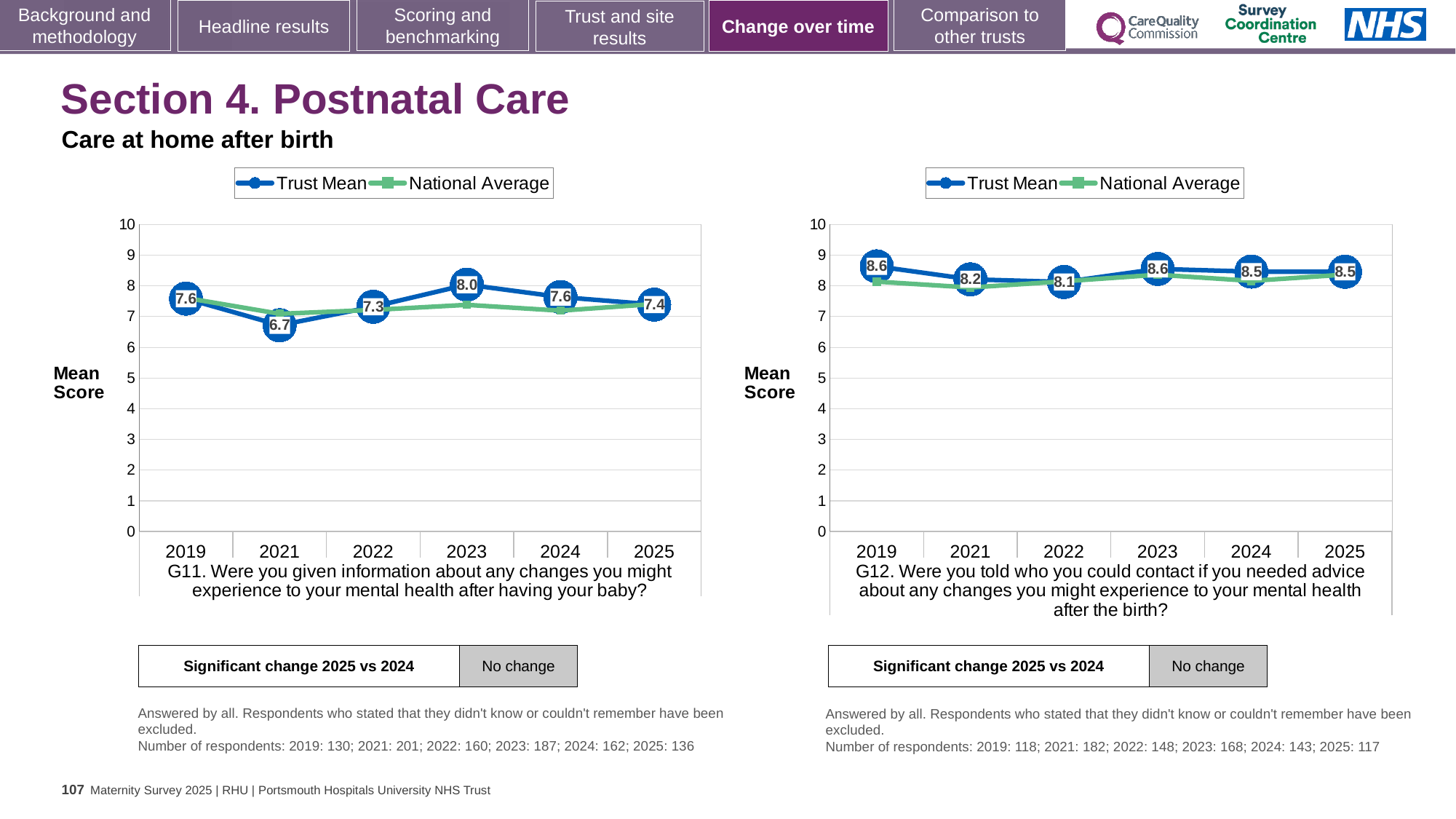
On the G11 chart (left), which year has the lowest Trust Mean score? 2021 How many series does the legend of the G12 chart (right) list? 2 What kind of chart is the G11 chart (left)? Line chart On the G11 chart (left), what is the Trust Mean score for 2021? 6.7 On the G12 chart (right), what is the Trust Mean score for 2019? 8.6 On the G11 chart (left), what is the Trust Mean score for 2023? 8.0 On the G12 chart (right), which is larger, the Trust Mean score for 2021 or for 2022? 2021 On the G11 chart (left), what is the difference between the Trust Mean scores for 2023 and 2021? 1.3 On the G11 chart (left), which year has the highest Trust Mean score? 2023 How many years are plotted on the G11 chart (left)? 6 On the G12 chart (right), is the Trust Mean score for 2025 greater or less than 8? greater On the G12 chart (right), what is the Trust Mean score for 2022? 8.1